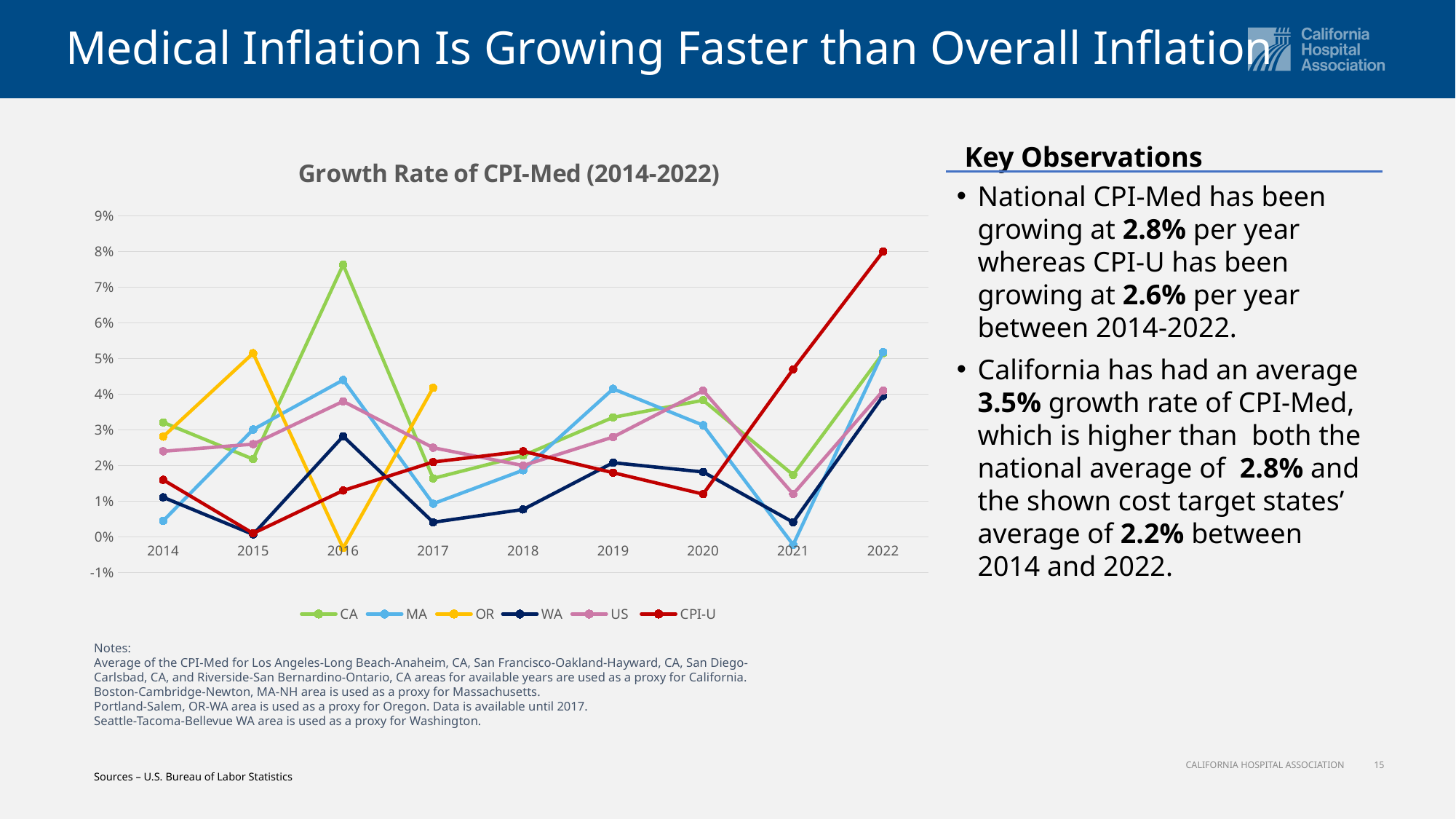
In 2021, which is larger: the value for CPI-U or the value for CA? CPI-U Is the value for WA in 2015 greater or less than 1%? less Which series has the highest value in 2022? CPI-U How many years are shown on the x axis of the chart? 9 Which series has the highest value in 2016? CA Which series has the lowest value in 2021? MA Is the value for CA in 2016 greater or less than 7%? greater Is the value for CPI-U in 2022 greater or less than 7%? greater How many series does the chart legend list? 6 What is the title of the chart? Growth Rate of CPI-Med (2014-2022) What kind of chart is shown on the slide? line chart Does the CPI-U series rise or fall from 2020 to 2022? rise